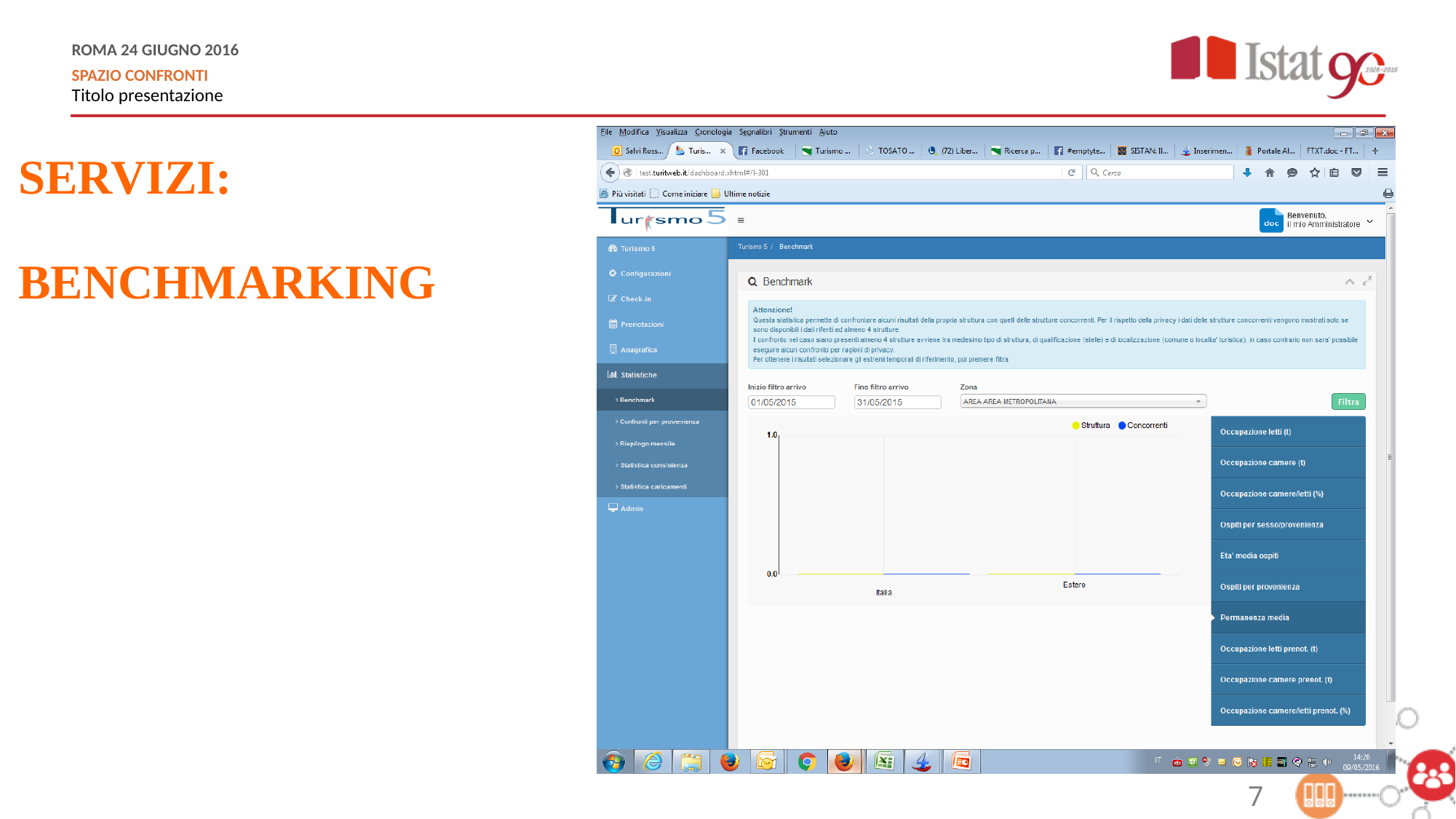
What are the category labels on the x axis of the chart? Italia and Estero What are the two series named in the chart legend? Struttura and Concorrenti Which statistic is selected in the menu to the right of the chart? Permanenza media What is the highest value shown on the chart's y axis? 1.0 Is the value for Concorrenti in the Estero category greater or less than 1.0? less How many categories are shown on the x axis of the chart? 2 Is the value for Struttura in the Italia category greater or less than 1.0? less Which colour represents the Struttura series in the chart? Yellow What is the lowest value shown on the chart's y axis? 0.0 How many series does the chart legend list? 2